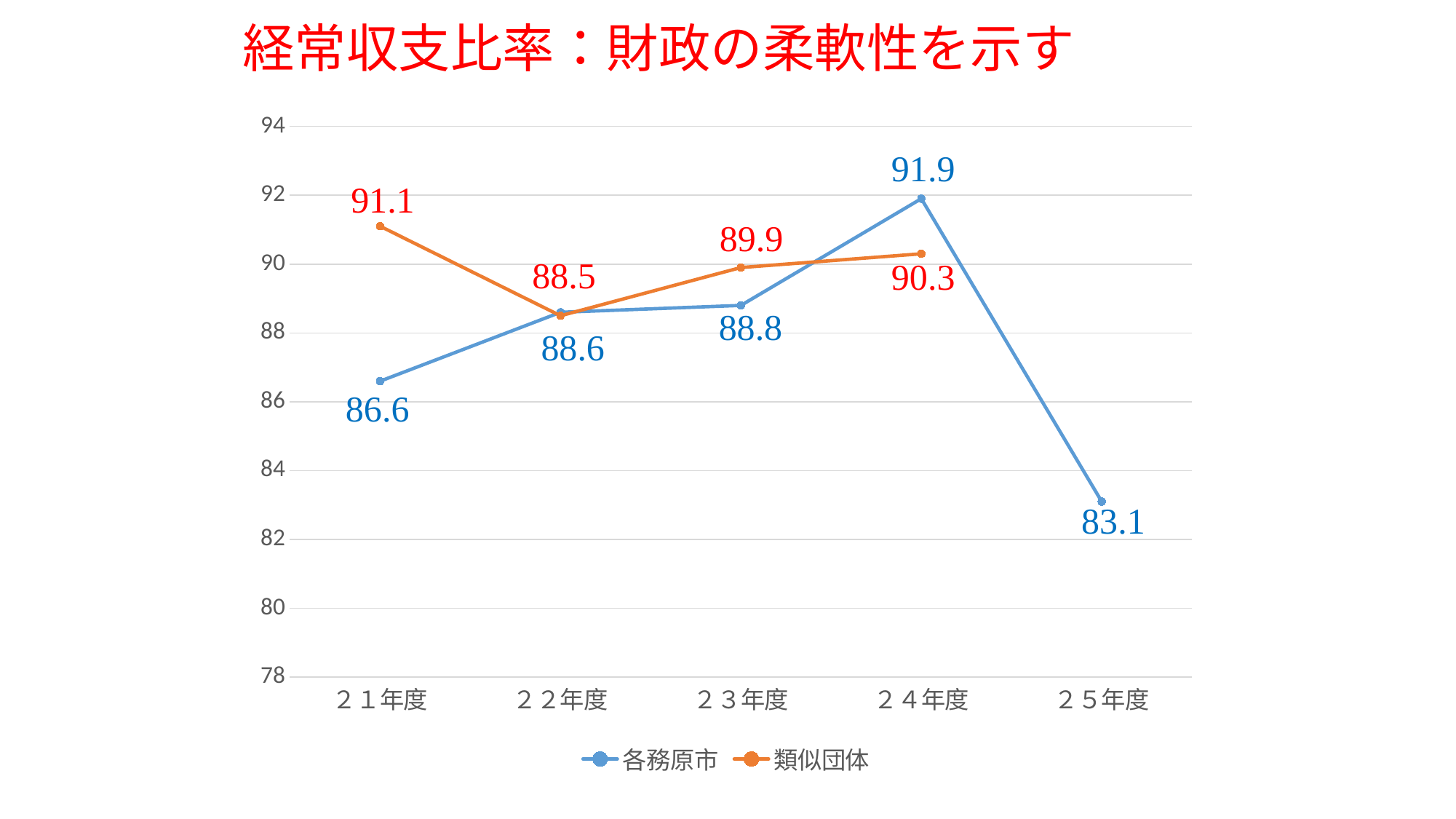
In which year is the value for 各務原市 lowest? ２５年度 What is the value for 類似団体 in ２３年度? 89.9 What is the value for 各務原市 in ２５年度? 83.1 In which year is the value for 各務原市 highest? ２４年度 How many years are shown on the x axis? 5 In which year is the value for 類似団体 lowest? ２２年度 Does the value for 各務原市 rise or fall from ２４年度 to ２５年度? fall Which is larger in ２４年度, 各務原市 or 類似団体? 各務原市 What type of chart is shown on the slide? line chart What is the value for 各務原市 in ２１年度? 86.6 What is the difference between 各務原市 and 類似団体 in ２１年度? 4.5 How many series does the legend list? 2